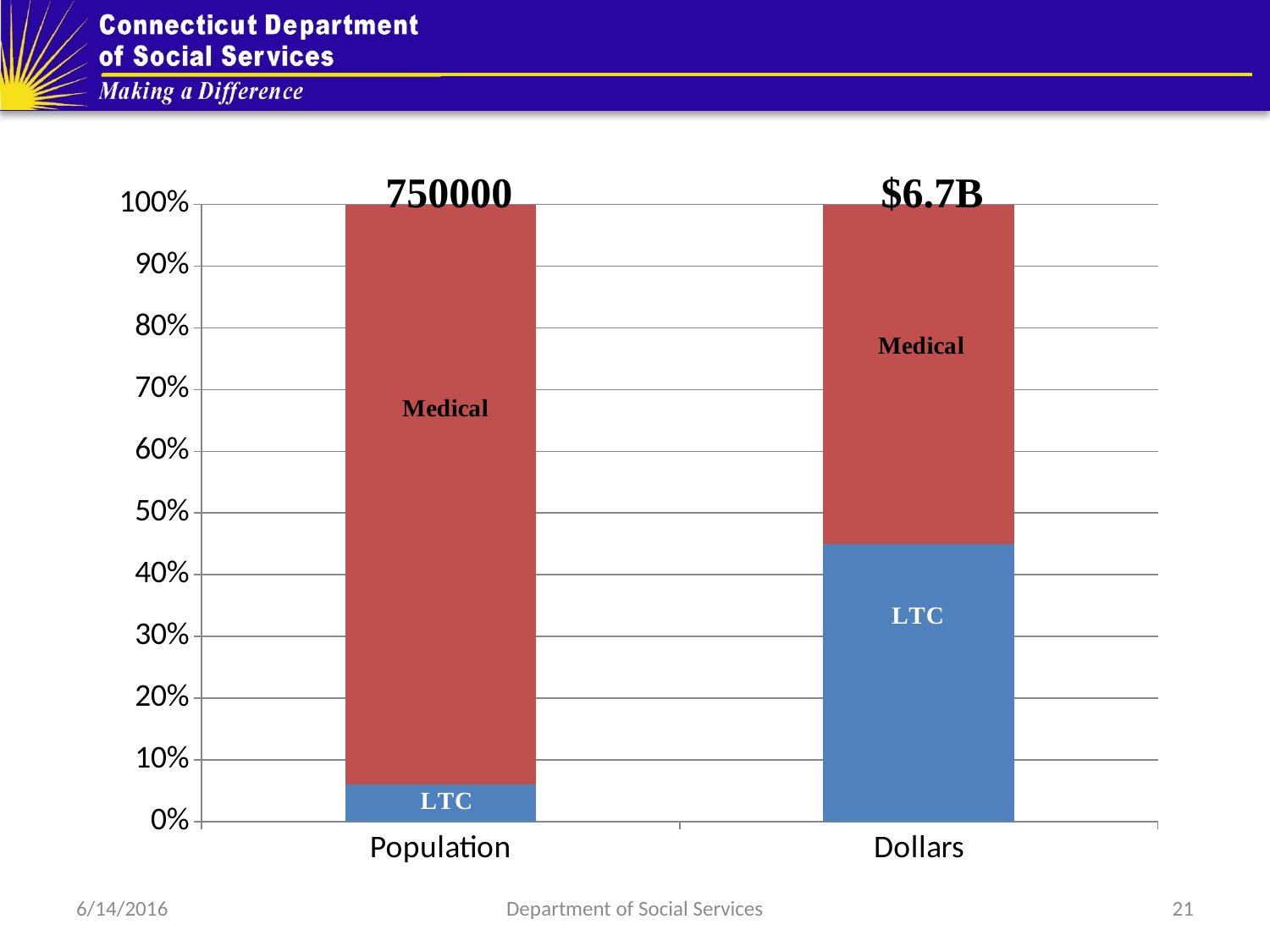
How many categories are shown on the x axis of the chart? 2 Which category has the larger Medical share, Population or Dollars? Population What label is printed above the Dollars bar? $6.7B Is the LTC share of the Dollars bar greater or less than 50%? less Is the LTC share of the Dollars bar greater or less than 40%? greater Is the LTC share of the Population bar greater or less than 10%? less How many segments (series) make up each stacked bar in the chart? 2 What label is printed above the Population bar? 750000 What are the two categories on the x axis of the chart? Population and Dollars What kind of chart is shown on the slide? Stacked bar chart Which category has the larger LTC share, Population or Dollars? Dollars